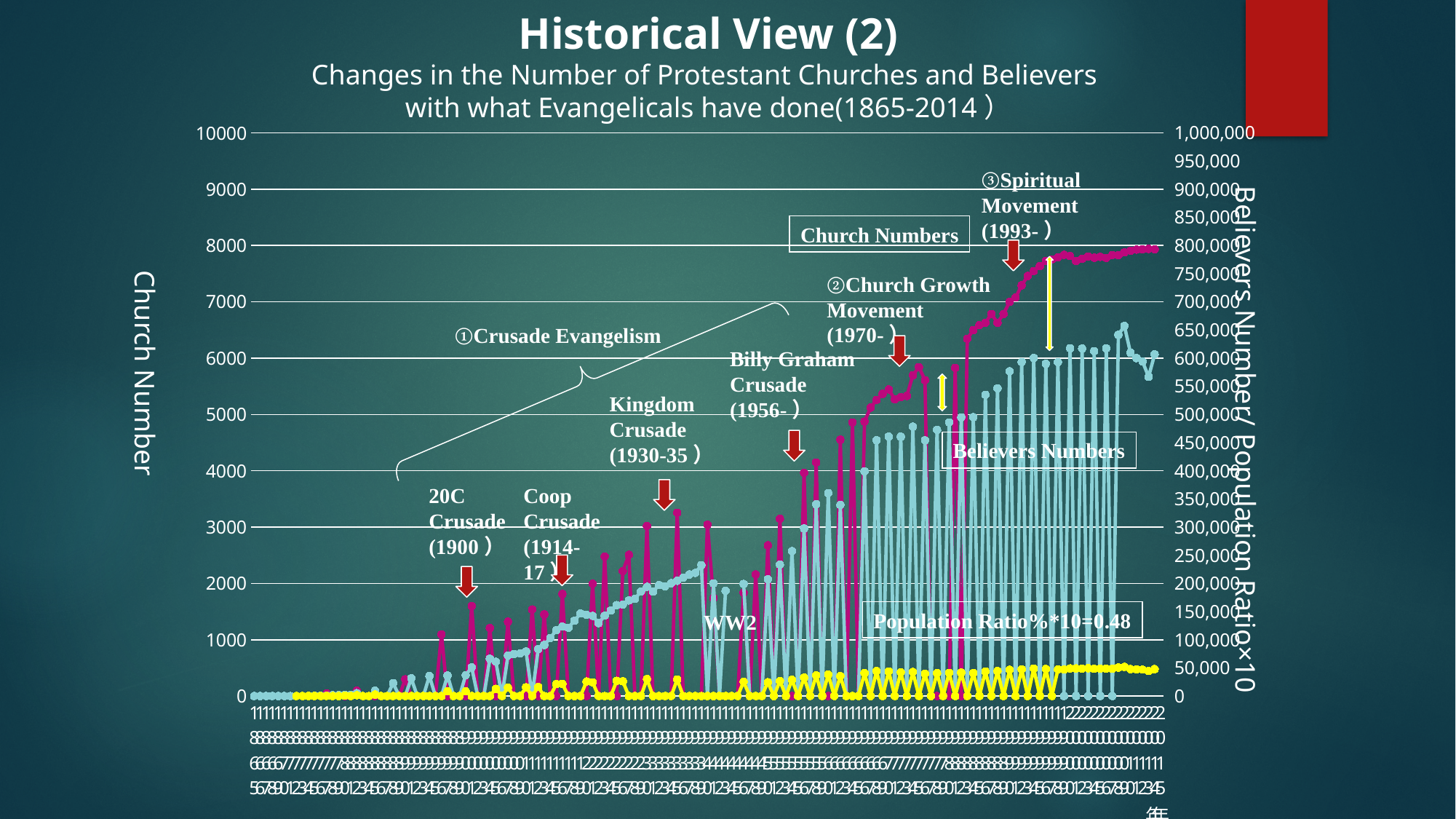
How many data series are plotted on the chart? 3 Is the value of the Church Numbers line at the left end of the chart (1865) greater or less than 1000 on the left axis? less What colour is the Church Numbers line? magenta Does the Believers Numbers series rise or fall overall from left to right along the x axis? rise Does the Church Numbers series rise or fall overall from left to right along the x axis? rise Is the value of the Church Numbers line at the right end of the chart greater or less than 7000 on the left axis? greater Is the peak of the Church Numbers line greater or less than 9000 on the left axis? less What kind of chart is shown on the slide? line chart What is the main title of the slide? Historical View (2)